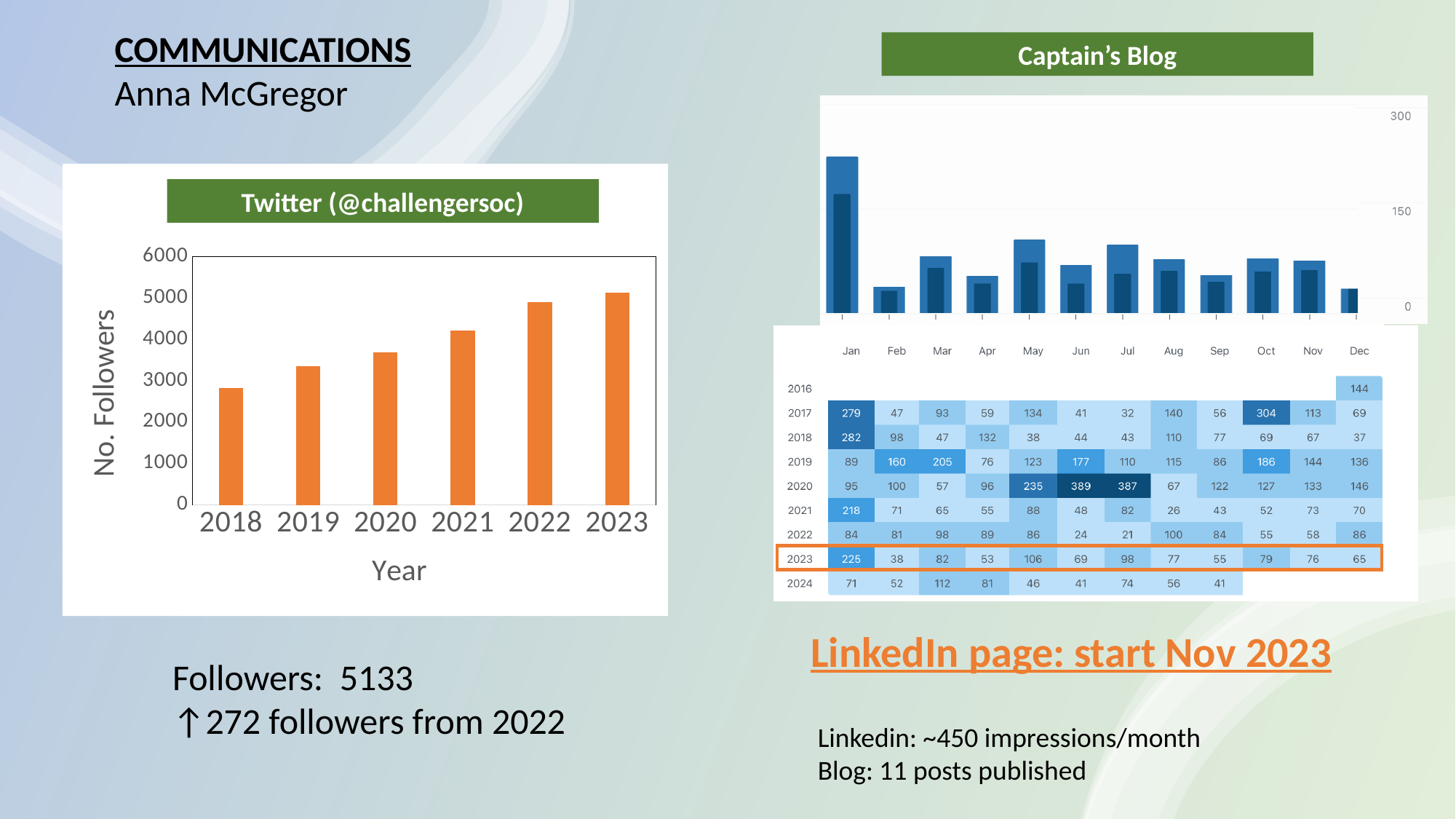
In the Twitter (@challengersoc) chart, is the value for 2021 greater or less than 4000? greater In the Captain's Blog table, what is the value for Jan 2023? 225 What kind of chart is the Twitter (@challengersoc) chart? bar chart In the Twitter (@challengersoc) chart, do the number of followers rise or fall from 2018 to 2023? rise In the Captain's Blog table, which month has the lowest value in the 2023 row? Feb In the Captain's Blog table, what is the value for Jun 2020? 389 How many years are shown on the x axis of the Twitter (@challengersoc) chart? 6 In the Twitter (@challengersoc) chart, is the value for 2023 greater or less than 5000? greater In the Twitter (@challengersoc) chart, which year has the lowest number of followers? 2018 In the Captain's Blog table, what is the difference between the Jun 2020 and Jul 2020 values? 2 In the Twitter (@challengersoc) chart, which year has the highest number of followers? 2023 In the Twitter (@challengersoc) chart, is the value for 2018 greater or less than 3000? less